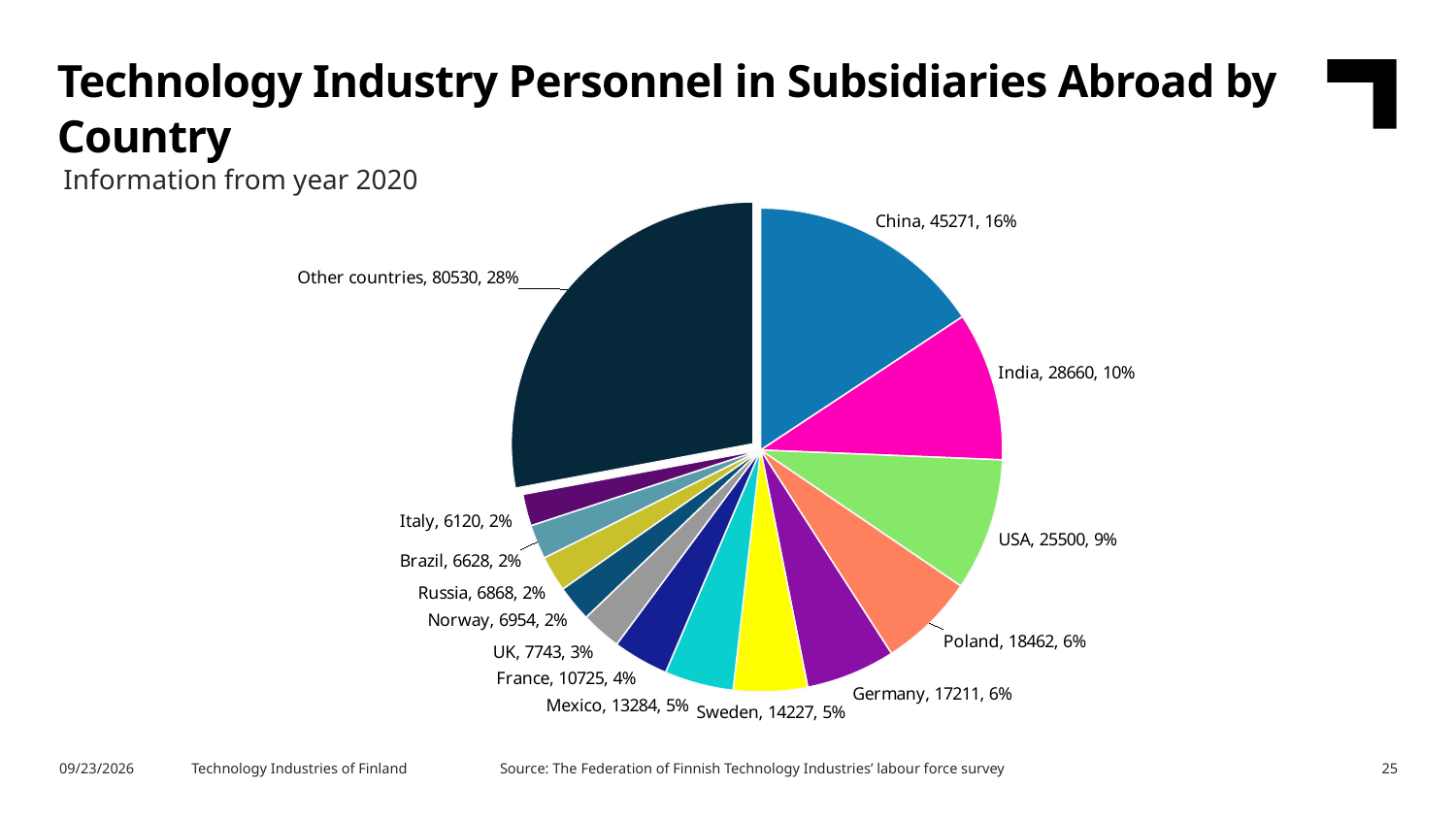
How many slices does the pie chart have? 14 What is the value shown for Poland? 18462 Which individually named country has the highest number of personnel? China Which has a larger value, USA or Germany? USA How many personnel are in subsidiaries in China according to the chart? 45271 What year is the information in the chart from? 2020 What share of the pie does India represent? 10% What is the difference between the values for China and India? 16611 Which country has the smallest slice in the pie chart? Italy What is the value shown for Sweden? 14227 Which slice of the pie is the largest? Other countries What type of chart is shown on the slide? Pie chart